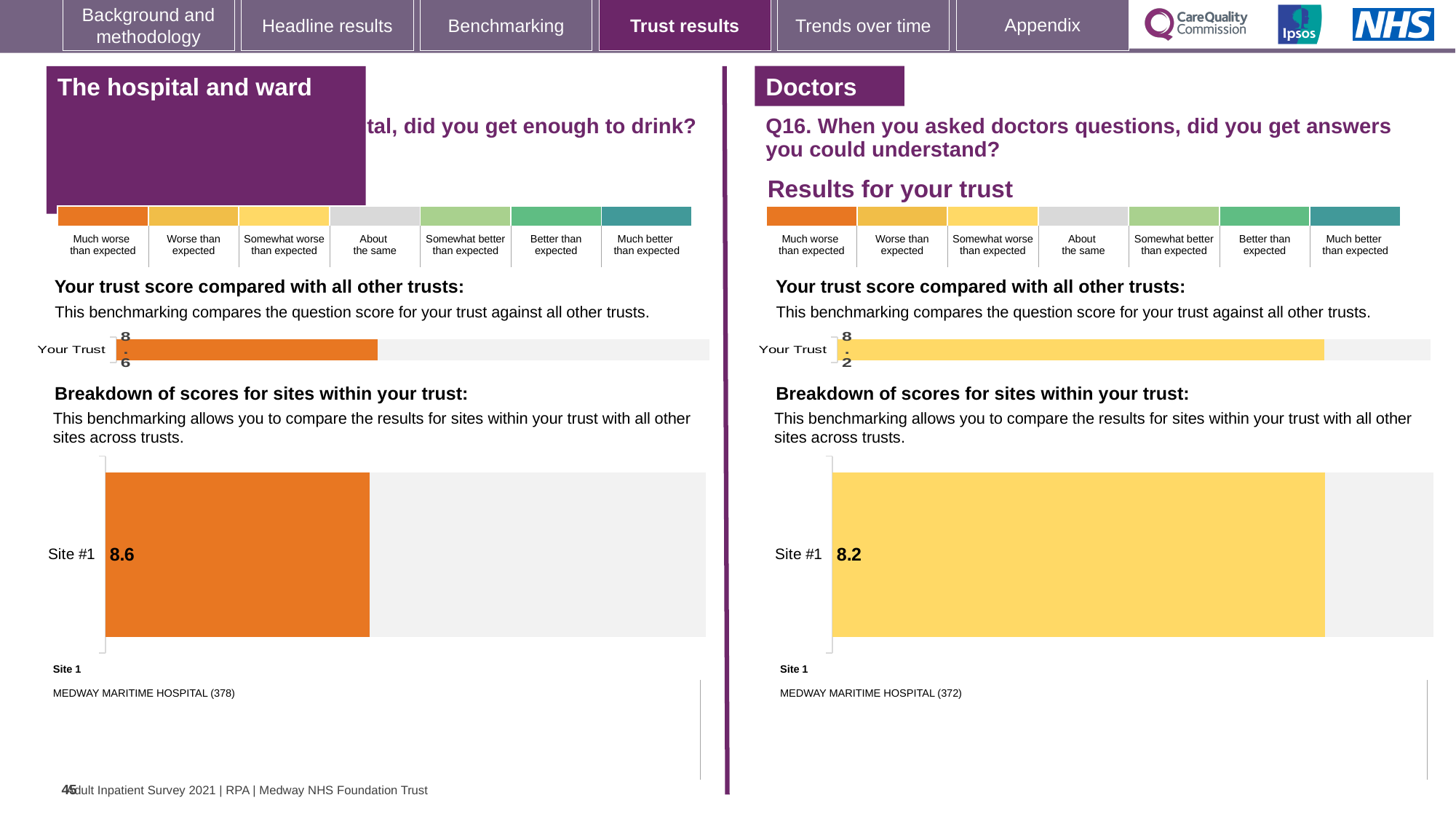
On the left-hand side of the slide, what is the 'Your Trust' score in the chart comparing the trust score with all other trusts? 8.6 On the right-hand side of the slide (Q16), what is the 'Your Trust' score in the chart comparing the trust score with all other trusts? 8.2 How many sites are shown in the breakdown of scores chart on the left-hand side of the slide? 1 What type of chart is used to show the Site #1 score on the right-hand side of the slide? Bar chart Which hospital is listed as Site 1 beneath the right-hand Q16 chart? MEDWAY MARITIME HOSPITAL (372) How many sites are shown in the breakdown of scores chart on the right-hand side of the slide (Q16)? 1 What is the difference between the Site #1 score on the left-hand chart (8.6) and the Site #1 score on the right-hand Q16 chart (8.2)? 0.4 Which Site #1 score is larger: the one on the left-hand chart or the one on the right-hand Q16 chart? The left-hand chart (8.6) On the right-hand side of the slide (Q16, Doctors), what score is shown for Site #1 in the breakdown of scores for sites within your trust? 8.2 What colour is the Site #1 bar on the right-hand side of the slide (Q16)? Yellow On the left-hand side of the slide, what score is shown for Site #1 in the breakdown of scores for sites within your trust? 8.6 What colour is the Site #1 bar on the left-hand side of the slide? Orange